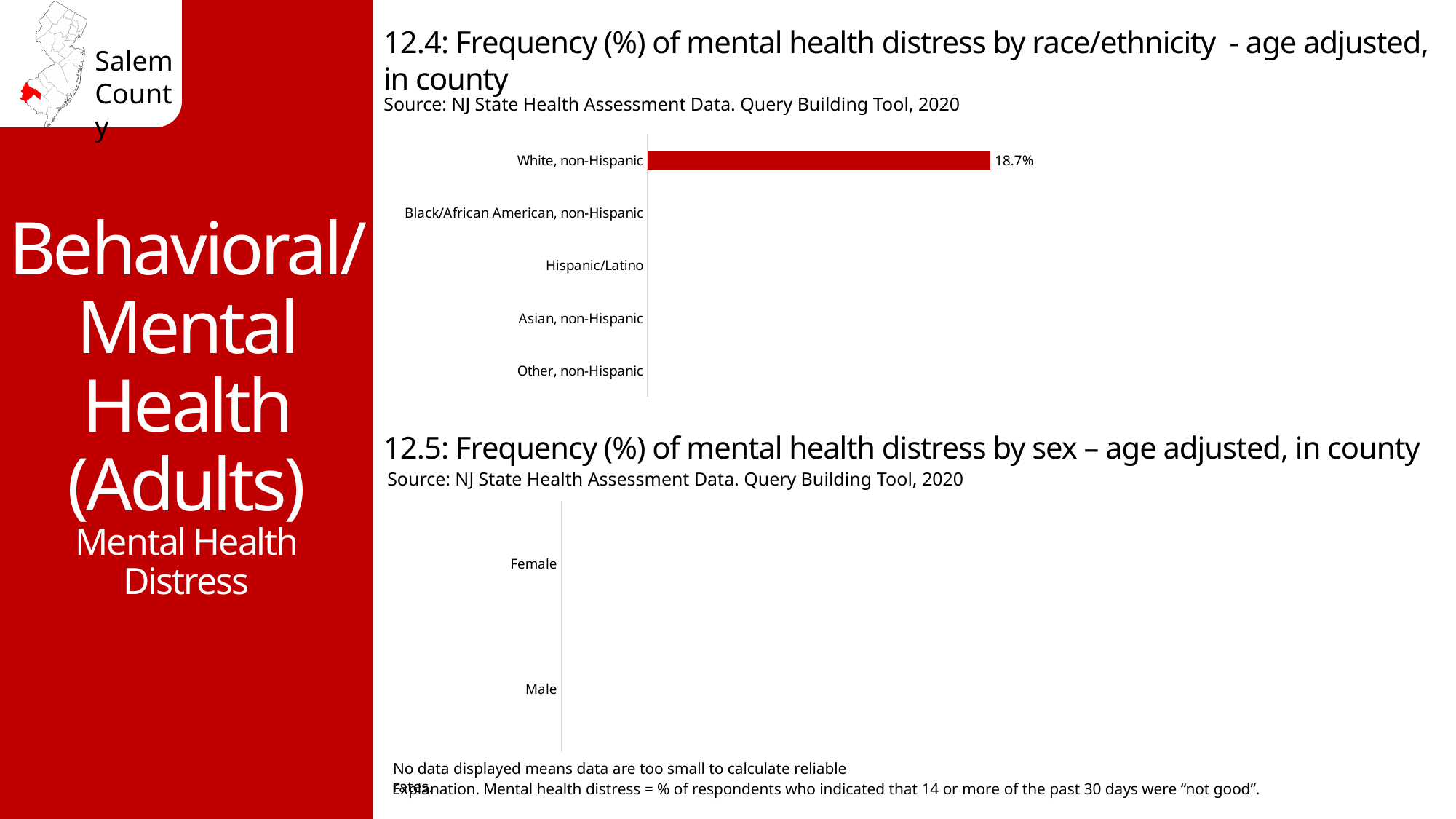
In chart 12.4 (mental health distress by race/ethnicity), is a value displayed for Hispanic/Latino? No In chart 12.5 (mental health distress by sex), which category is listed first (at the top) on the axis? Female In chart 12.4 (mental health distress by race/ethnicity), which race/ethnicity category has a bar displayed? White, non-Hispanic In chart 12.5 (mental health distress by sex), how many categories are listed on the axis? 2 What is the source cited for chart 12.4 (mental health distress by race/ethnicity)? NJ State Health Assessment Data. Query Building Tool, 2020 In chart 12.4 (mental health distress by race/ethnicity), what is the value for White, non-Hispanic? 18.7% In chart 12.4 (mental health distress by race/ethnicity), how many race/ethnicity categories are listed on the axis? 5 In chart 12.4 (mental health distress by race/ethnicity), how many categories have a data value displayed? 1 In chart 12.5 (mental health distress by sex), are any data values displayed for Female or Male? No In chart 12.4 (mental health distress by race/ethnicity), which category is listed last (at the bottom) on the axis? Other, non-Hispanic In chart 12.4 (mental health distress by race/ethnicity), what kind of chart is shown? Bar chart